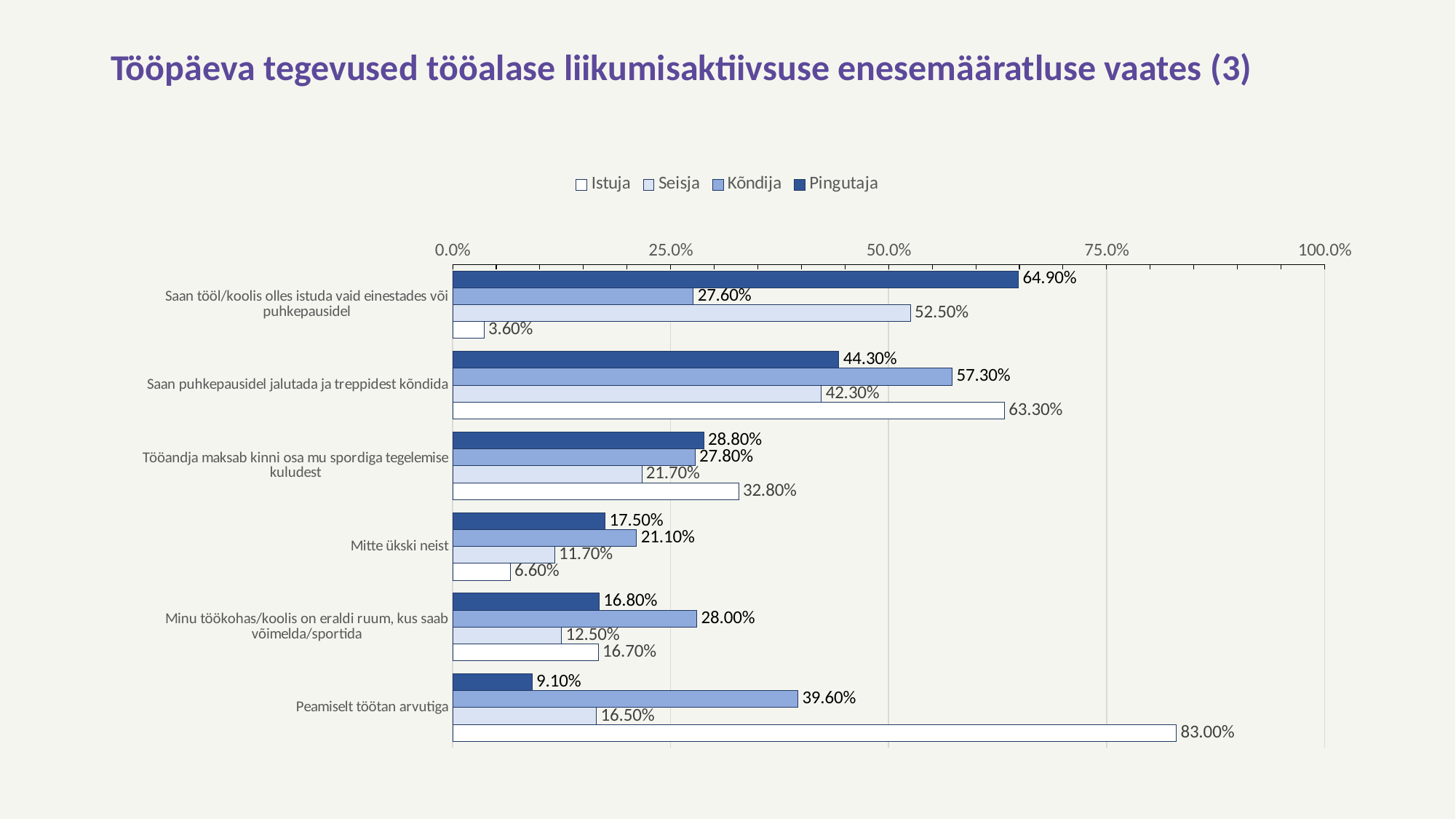
For "Saan puhkepausidel jalutada ja treppidest kõndida", which is larger: the Kõndija value or the Seisja value? Kõndija How many series does the legend list? 4 What is the difference between the Istuja and Pingutaja values for "Peamiselt töötan arvutiga"? 73.90% What is the Istuja value for "Peamiselt töötan arvutiga"? 83.00% What kind of chart is shown on the slide? Bar chart How many categories are shown on the vertical axis of the chart? 6 What is the Seisja value for "Mitte ükski neist"? 11.70% What is the Pingutaja value for "Saan tööl/koolis olles istuda vaid einestades või puhkepausidel"? 64.90% Which category has the highest Istuja value? Peamiselt töötan arvutiga Is the Seisja value for "Saan tööl/koolis olles istuda vaid einestades või puhkepausidel" greater or less than 50.0%? greater Which category has the lowest Pingutaja value? Peamiselt töötan arvutiga What is the Kõndija value for "Minu töökohas/koolis on eraldi ruum, kus saab võimelda/sportida"? 28.00%